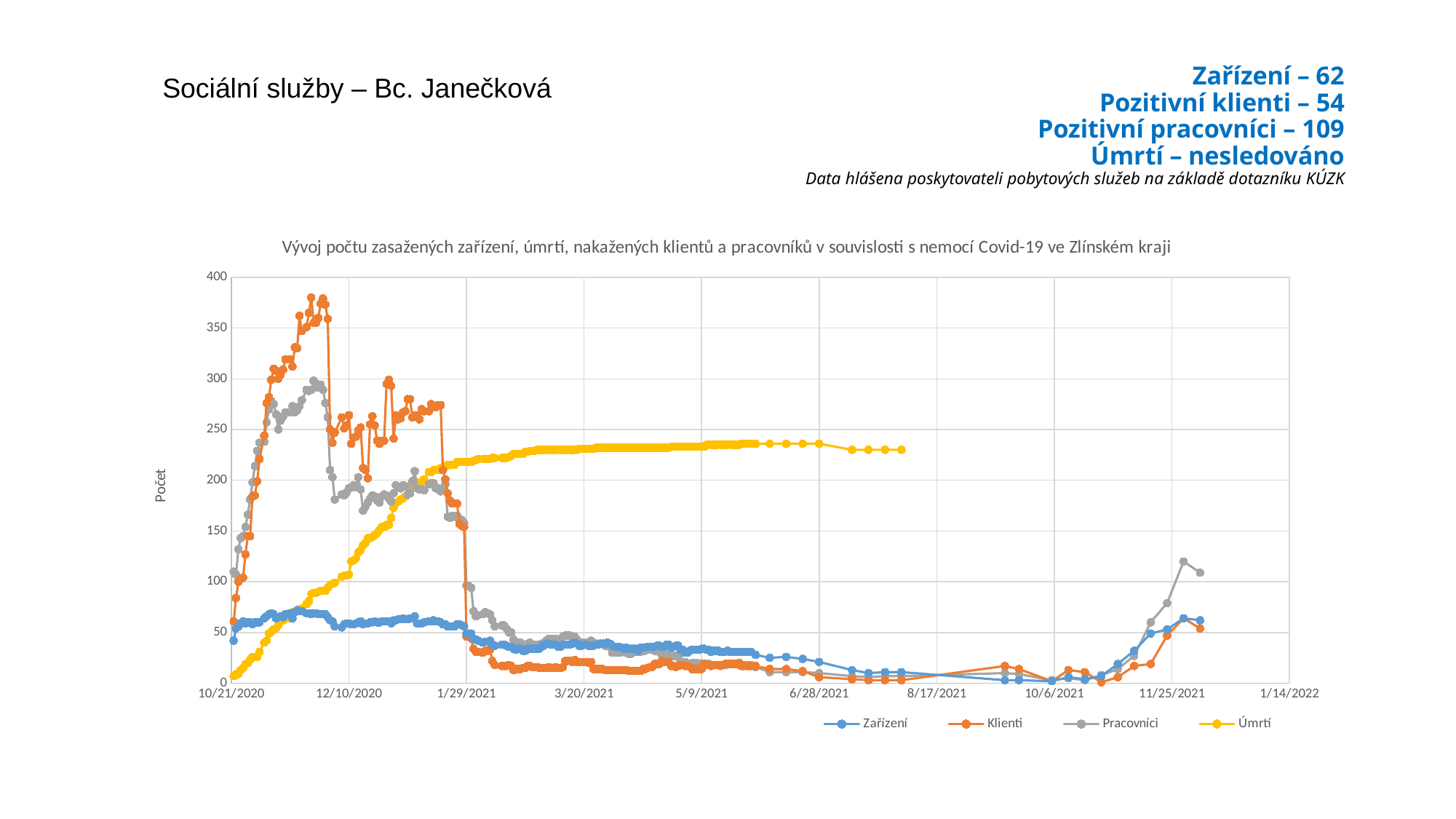
What is the label of the vertical axis of the chart? Počet What are the series names listed in the chart legend? Zařízení, Klienti, Pracovníci, Úmrtí Which series reaches the highest peak value on the chart? Klienti Is the peak value of the Pracovníci series greater or less than 250? greater Does the Klienti series rise or fall between 1/29/2021 and 3/20/2021? fall Which series has the highest value at 5/9/2021? Úmrtí Is the peak value of the Klienti series greater or less than 350? greater What kind of chart is shown on the slide? line chart Does the Úmrtí series rise or fall between 10/21/2020 and 6/28/2021? rise Is the value of the Zařízení series at 3/20/2021 greater or less than 50? less How many series does the chart legend list? 4